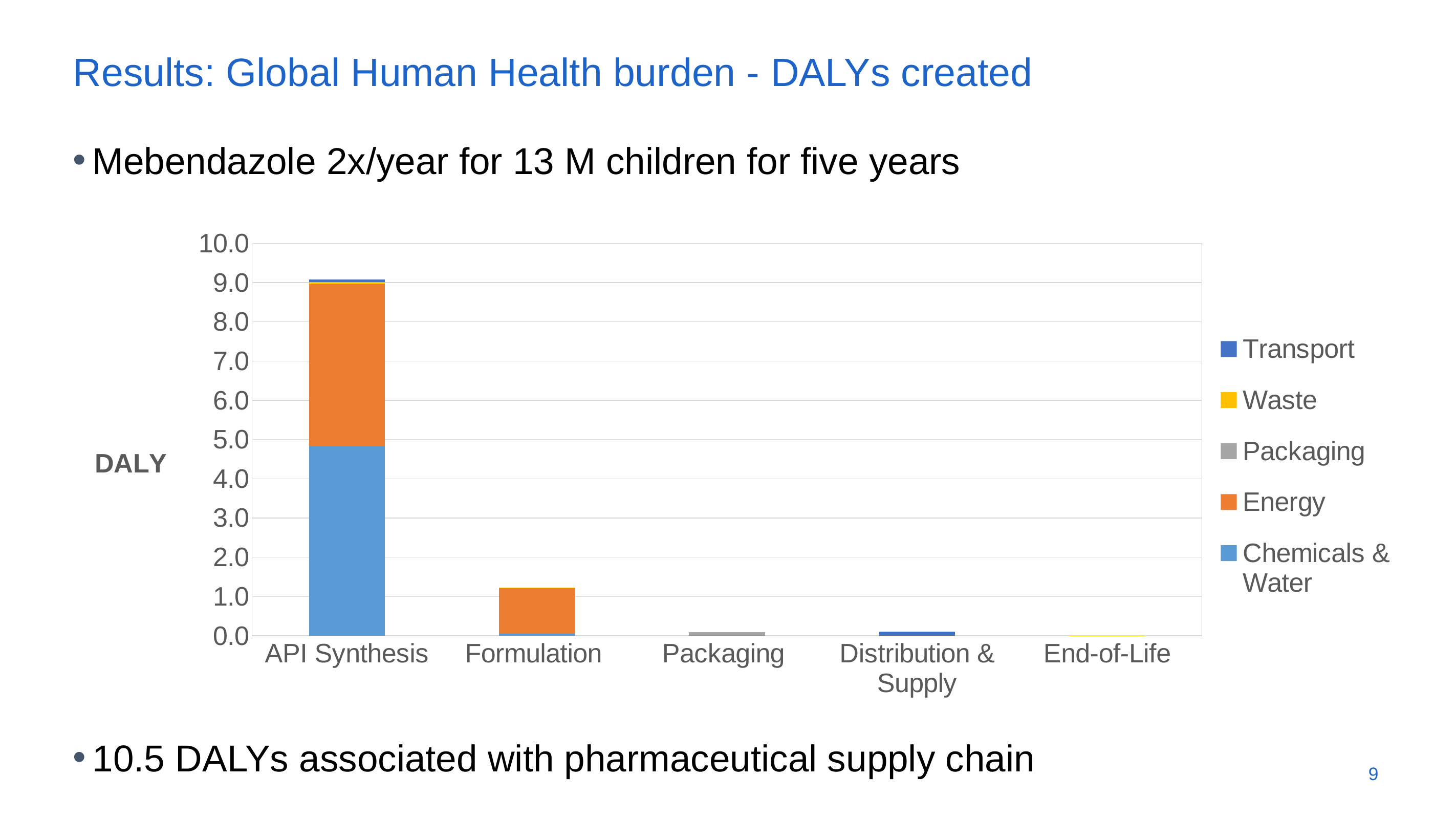
Is the total value for Formulation greater or less than 1.0? greater What is the label on the y axis of the chart? DALY How many series does the chart's legend list? 5 Is the total value for Formulation greater or less than 2.0? less How many categories are shown on the x axis of the chart? 5 Which category has the highest total DALY value? API Synthesis Which has a larger total DALY value, Formulation or Packaging? Formulation What kind of chart is shown on the slide? stacked bar chart Which series makes up almost all of the Formulation bar? Energy Is the Chemicals & Water value for API Synthesis greater or less than 4.0? greater Which has a larger total DALY value, API Synthesis or Formulation? API Synthesis